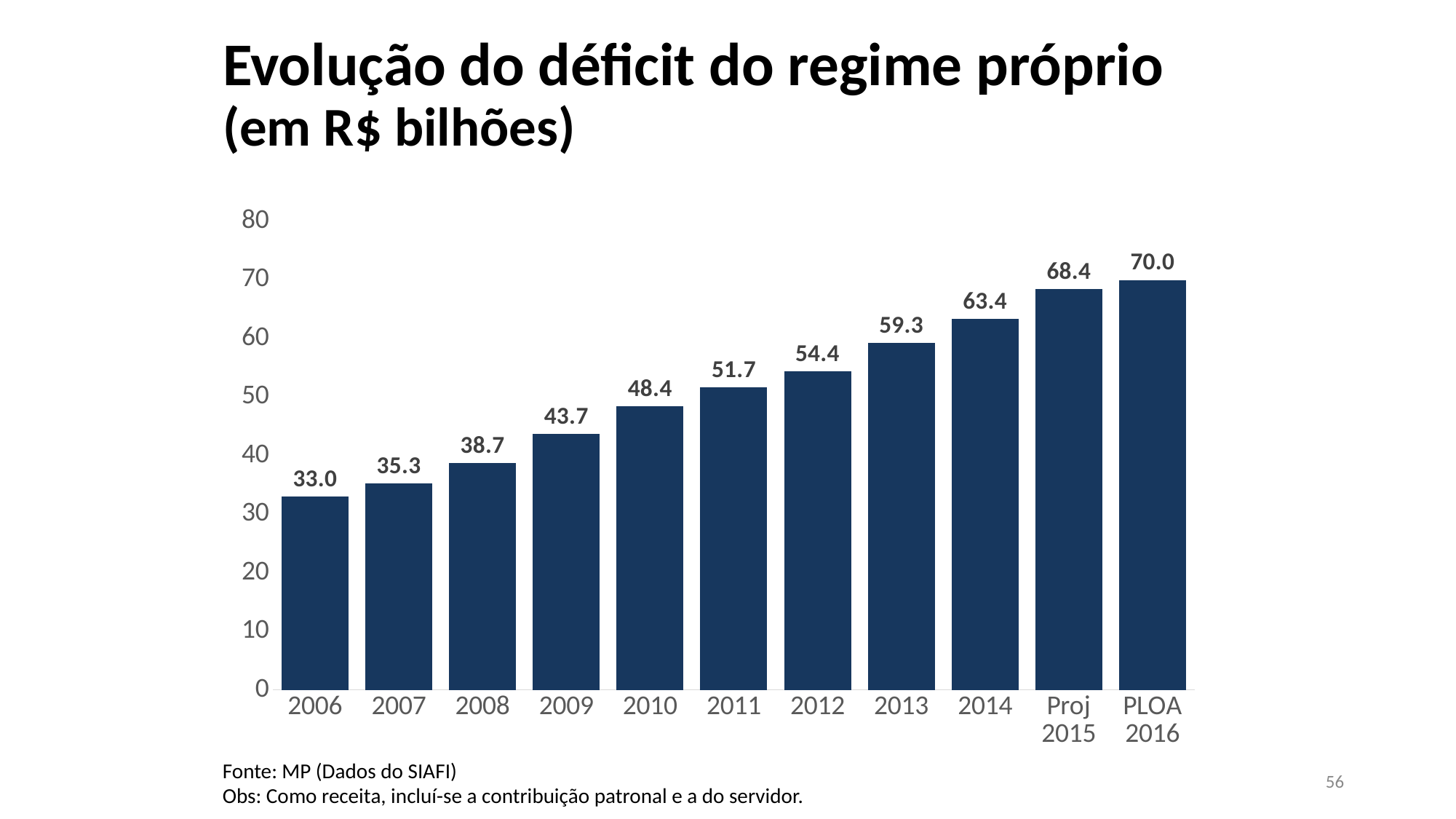
What is the value for 2006? 33.0 Do the values rise or fall from 2006 to PLOA 2016? rise What is the value for PLOA 2016? 70.0 Is the value for 2011 greater or less than 50? greater What is the value for 2010? 48.4 Which is larger, the value for 2009 or the value for 2012? 2012 What kind of chart is shown on the slide? bar chart Which category has the highest value? PLOA 2016 How many bars are shown in the chart? 11 Which category has the lowest value? 2006 What is the difference between the values for 2014 and 2013? 4.1 What is the difference between the values for PLOA 2016 and 2006? 37.0